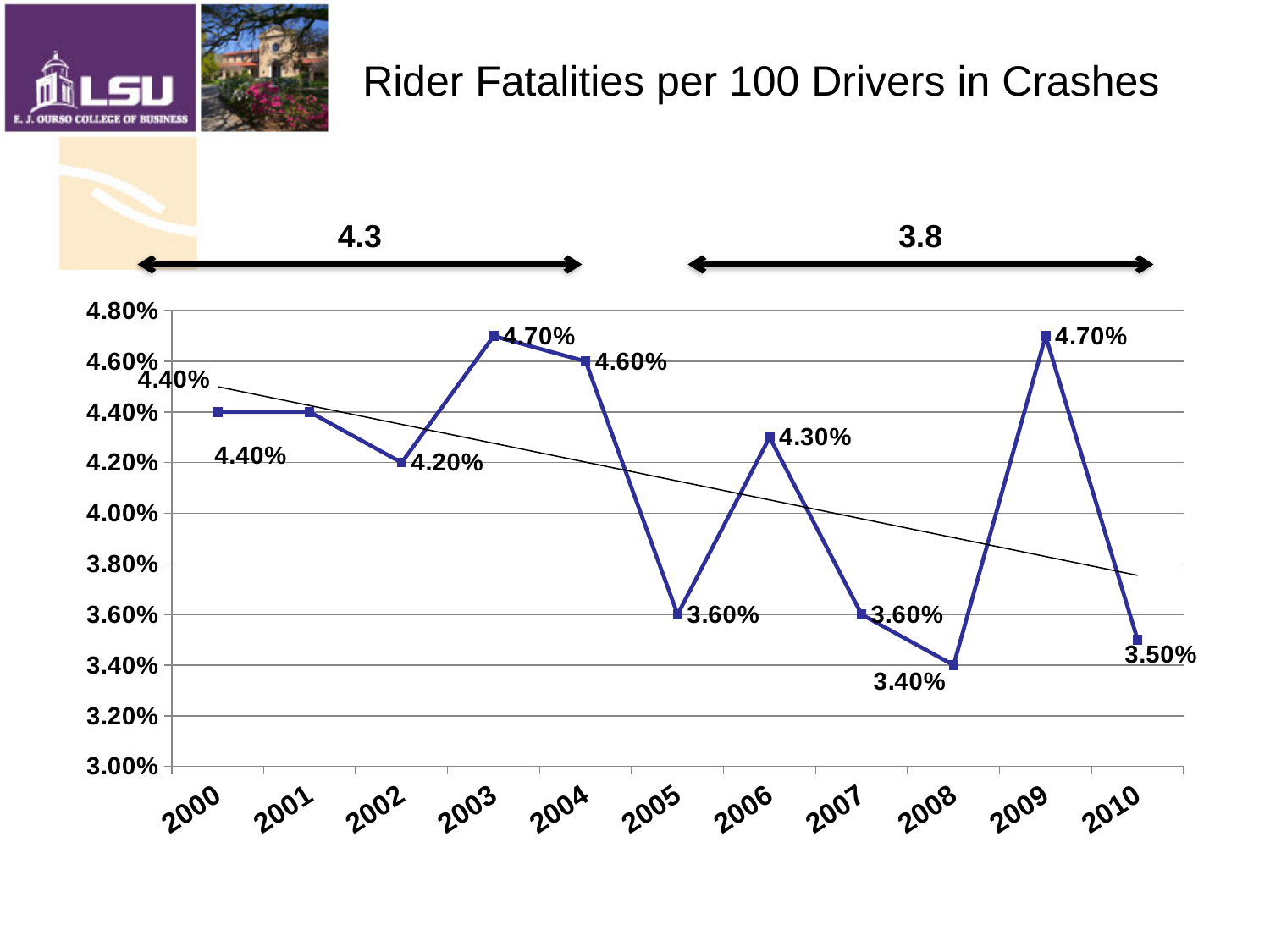
Which year has a higher rider fatality rate, 2002 or 2006? 2006 What is the rider fatality rate for 2010? 3.50% Does the thin trend line rise or fall from 2000 to 2010? Fall Which year has the lowest rider fatality rate? 2008 What is the rider fatality rate for 2003? 4.70% What is the rider fatality rate for 2006? 4.30% What kind of chart is shown on the slide? Line chart What is the rider fatality rate for 2008? 3.40% What is the difference between the rider fatality rate in 2004 and in 2005? 1.00% How many years are plotted on the x axis? 11 Which two years share the highest rider fatality rate of 4.70%? 2003 and 2009 What is the title of the chart? Rider Fatalities per 100 Drivers in Crashes